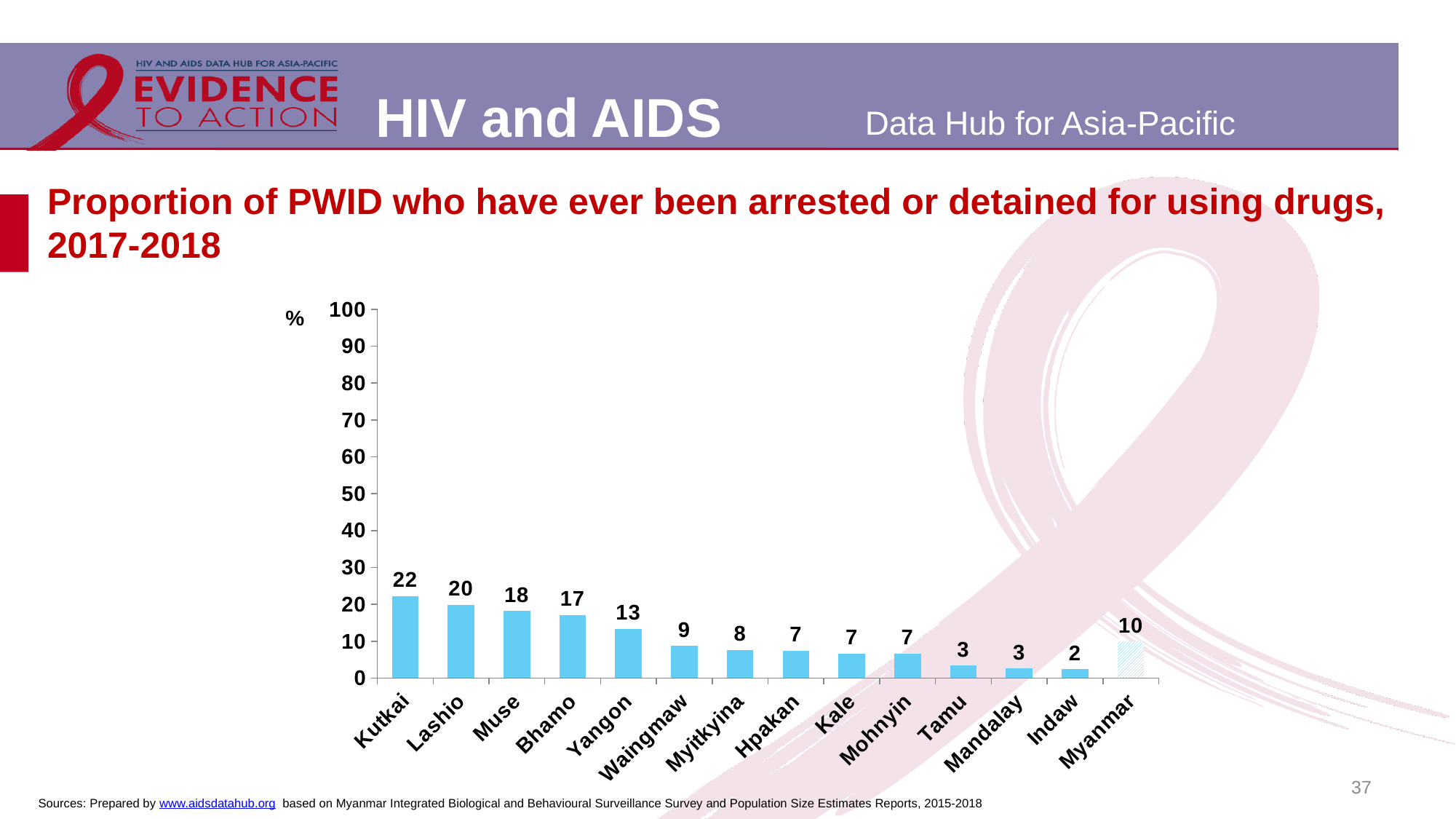
What is the maximum value shown on the y axis? 100 Do the values generally rise or fall from Kutkai to Indaw along the x axis? fall What kind of chart is shown on the slide? bar chart Which category has the lowest value? Indaw What is the difference between the values for Lashio and Muse? 2 What is the value for Yangon? 13 What is the value for Myanmar? 10 What is the value for Kutkai? 22 Which category has the highest value? Kutkai How many categories are shown on the x axis? 14 Which is larger, the value for Bhamo or the value for Waingmaw? Bhamo Is the value for Kutkai greater or less than 30? less